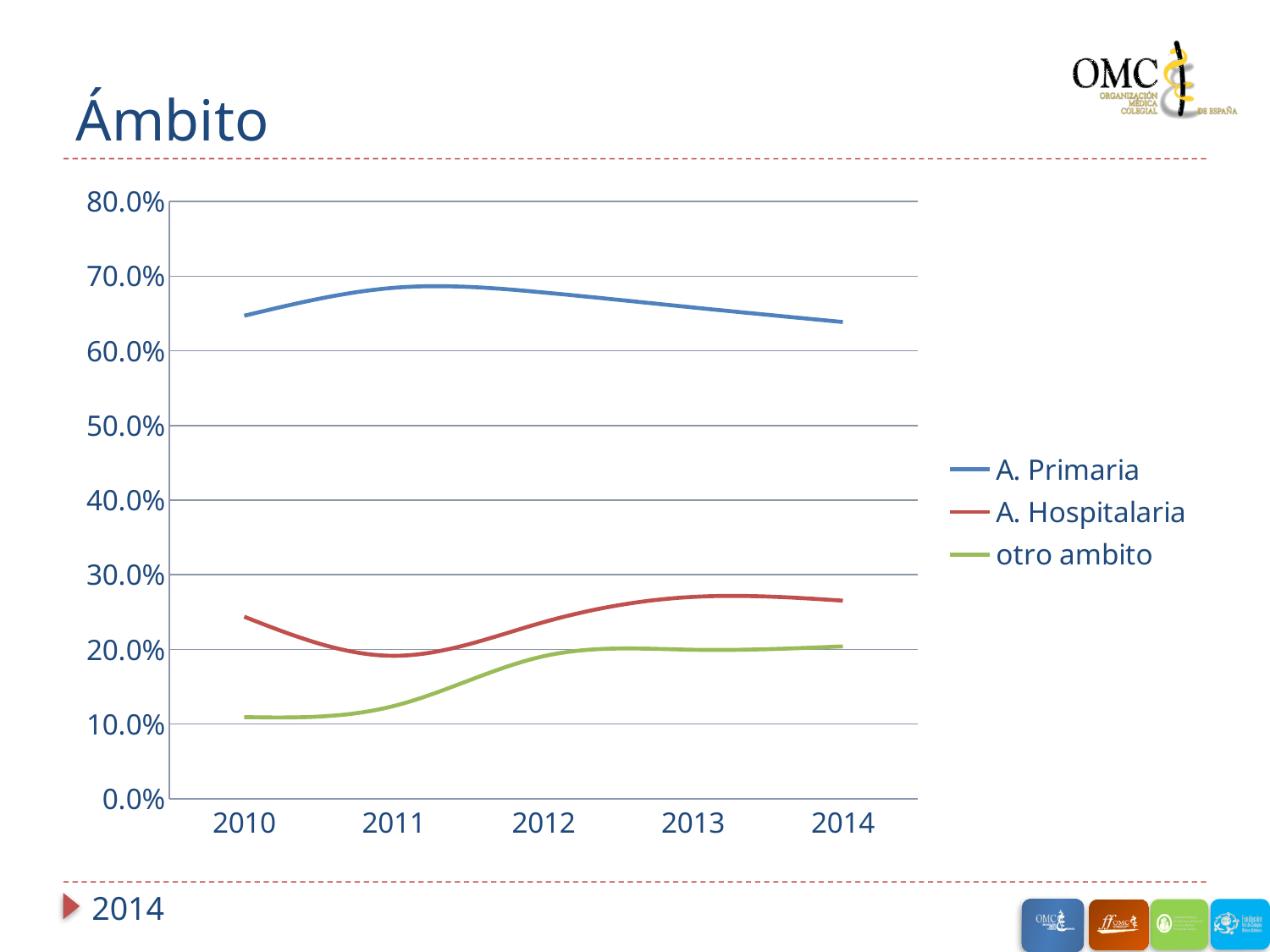
Is the value for otro ambito in 2010 greater or less than 20%? less How many years are shown on the x axis? 5 Which series has the highest value in 2012? A. Primaria What kind of chart is shown on the slide? line chart Does the value for otro ambito rise or fall from 2010 to 2014? rise How many series does the legend list? 3 In which year is A. Hospitalaria at its lowest value? 2011 In 2014, which is larger: A. Hospitalaria or otro ambito? A. Hospitalaria Is the value for A. Primaria in 2011 greater or less than 70%? less Is the value for A. Primaria in 2010 greater or less than 60%? greater What is the title of the slide containing the chart? Ámbito